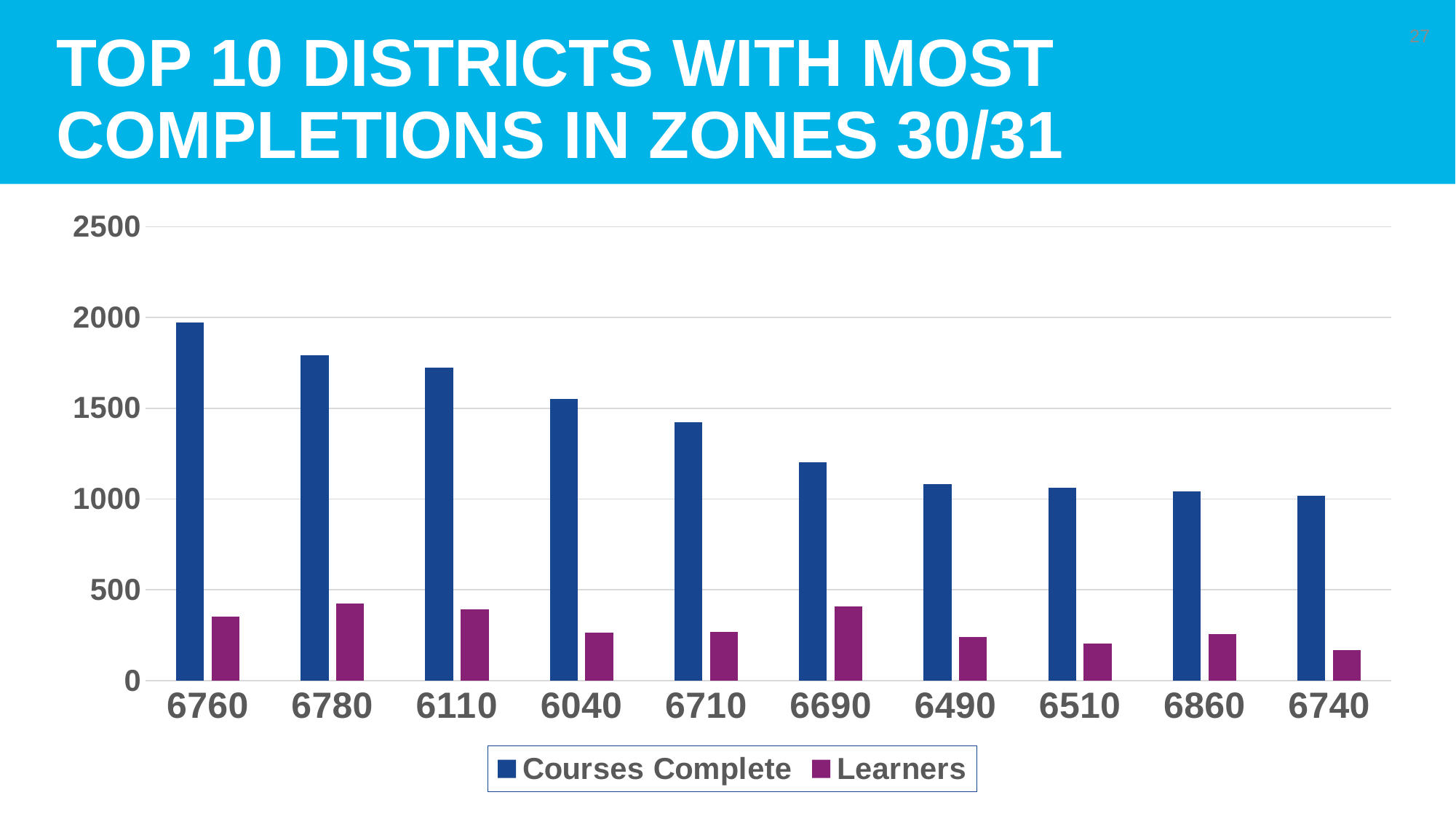
Do the Courses Complete values rise or fall from left to right along the x axis? fall Is the Learners value for 6780 greater or less than 500? less Which is larger, the Courses Complete value for 6760 or for 6740? 6760 How many series does the legend list? 2 Is the Courses Complete value for 6710 greater or less than 1500? less Which district has the lowest Learners value? 6740 What is the title of the chart on the slide? TOP 10 DISTRICTS WITH MOST COMPLETIONS IN ZONES 30/31 Is the Courses Complete value for 6760 greater or less than 1500? greater How many districts are shown on the x axis? 10 Which district has the highest Courses Complete value? 6760 What kind of chart is shown on the slide? bar chart